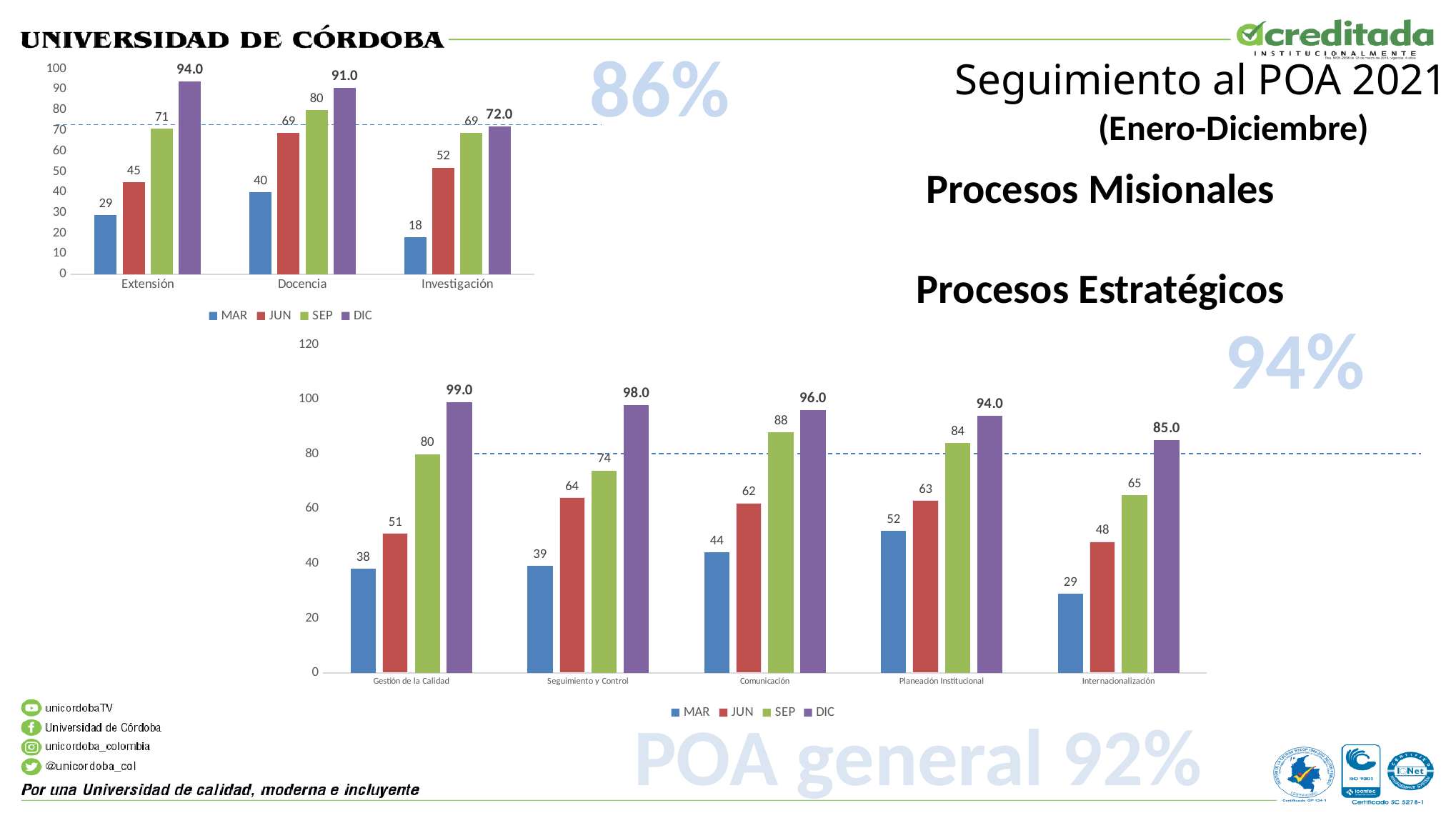
In the bottom chart, which category has the highest DIC value? Gestión de la Calidad How many categories are shown on the x axis of the bottom chart? 5 In the top-left chart, what is the difference between the SEP and JUN values for Docencia? 11 In the bottom chart, what is the SEP value for Comunicación? 88 In the bottom chart, what is the DIC value for Internacionalización? 85.0 In the bottom chart, is the JUN value for Seguimiento y Control larger than the JUN value for Comunicación? Yes In the top-left chart, what is the MAR value for Investigación? 18 In the bottom chart, which category has the highest MAR value? Planeación Institucional In the top-left chart, how many series does the legend list? 4 In the top-left chart, which category has the lowest DIC value? Investigación In the top-left chart, what is the DIC value for Extensión? 94.0 What type of chart is the bottom chart? Bar chart